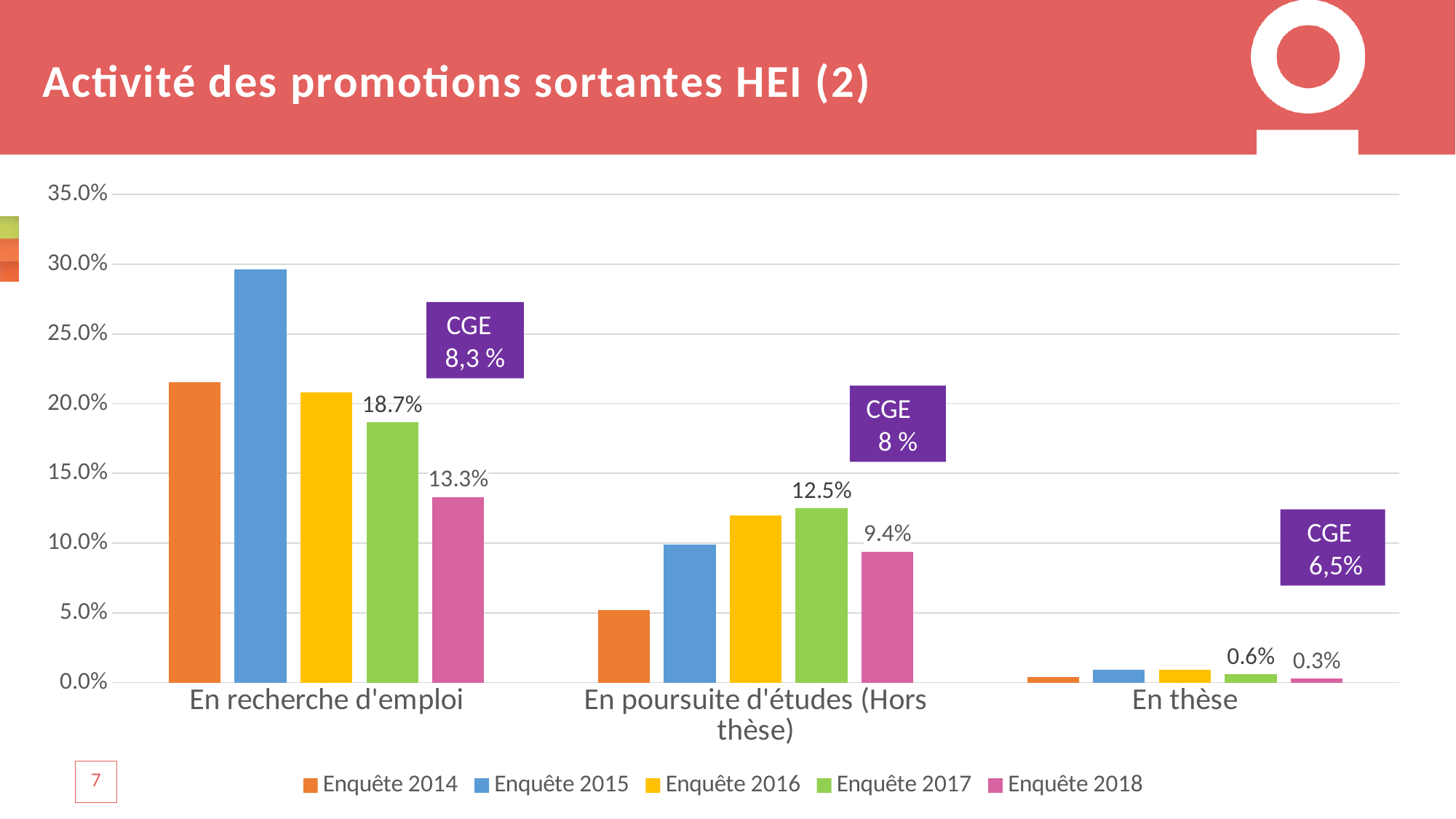
Which survey has the lowest bar in the 'En poursuite d'études (Hors thèse)' category? Enquête 2014 What is the value for Enquête 2017 in the 'En recherche d'emploi' category? 18.7% How many categories are shown on the x axis? 3 Which survey has the highest bar in the 'En recherche d'emploi' category? Enquête 2015 What is the value for Enquête 2018 in the 'En thèse' category? 0.3% What kind of chart is shown on the slide? Bar chart What is the value for Enquête 2018 in the 'En poursuite d'études (Hors thèse)' category? 9.4% What is the difference between the Enquête 2017 and Enquête 2018 values in the 'En recherche d'emploi' category? 5.4% How many series does the legend list? 5 What is the value for Enquête 2017 in the 'En thèse' category? 0.6% Is the value for Enquête 2015 in the 'En recherche d'emploi' category greater or less than 25.0%? greater Which is larger in the 'En poursuite d'études (Hors thèse)' category: Enquête 2017 or Enquête 2018? Enquête 2017